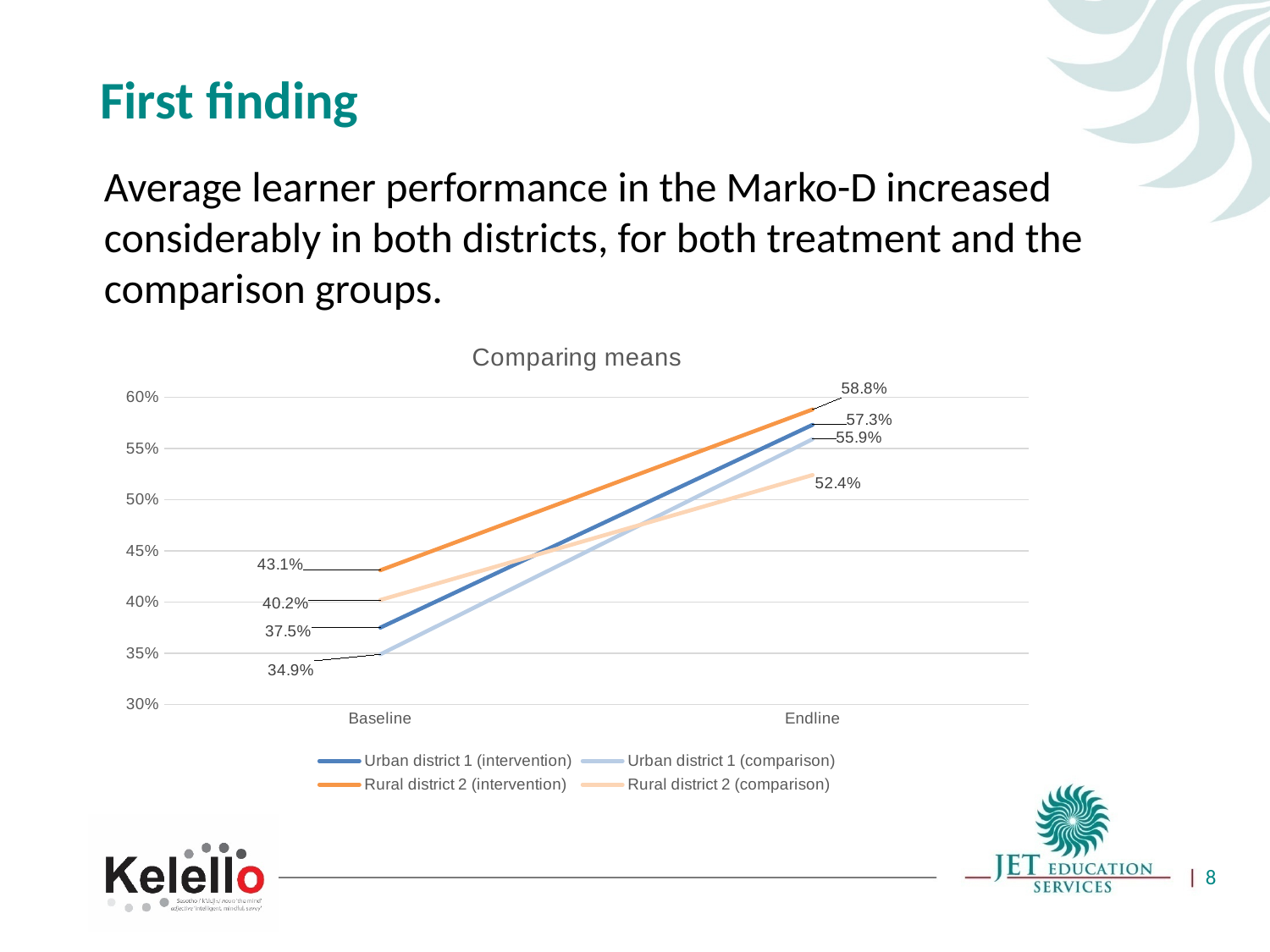
What is the Baseline value for Urban district 1 (comparison)? 34.9% How many series does the chart legend list? 4 What is the title of the chart? Comparing means What type of chart is shown on the slide? Line chart What is the Endline value for Rural district 2 (intervention)? 58.8% At Endline, which is larger: Urban district 1 (comparison) or Rural district 2 (comparison)? Urban district 1 (comparison) Which series has the lowest value at Baseline? Urban district 1 (comparison) What is the Endline value for Rural district 2 (comparison)? 52.4% What is the difference between the Baseline and Endline values for Urban district 1 (intervention)? 19.8 percentage points Do the values for Rural district 2 (comparison) rise or fall from Baseline to Endline? Rise Which series has the highest value at Endline? Rural district 2 (intervention) How many points are on the x axis of the chart? 2